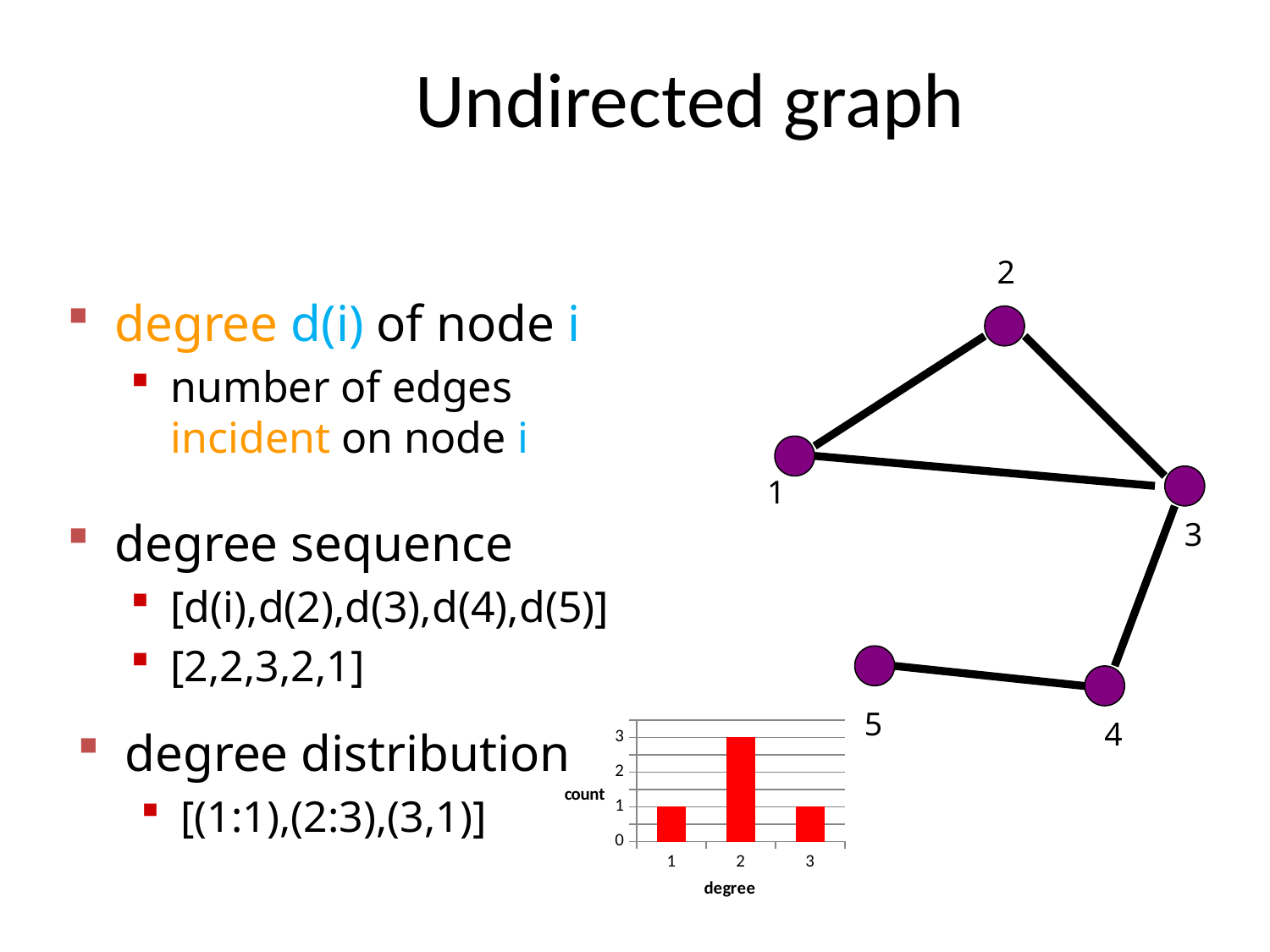
In the bar chart, what is the difference between the count for degree 2 and the count for degree 1? 2 What is the label of the x axis of the bar chart? degree In the bar chart, what is the count for degree 2? 3 Which degree has the highest count in the bar chart? 2 How many degree categories are shown on the x axis of the bar chart? 3 In the bar chart, what is the count for degree 1? 1 In the bar chart, what is the total of the counts across all three degrees? 5 What kind of chart is shown at the bottom of the slide? bar chart In the bar chart, what is the count for degree 3? 1 What is the label of the y axis of the bar chart? count In the bar chart, is the count for degree 2 larger than the count for degree 3? yes In the bar chart, is the count for degree 2 greater or less than 2? greater